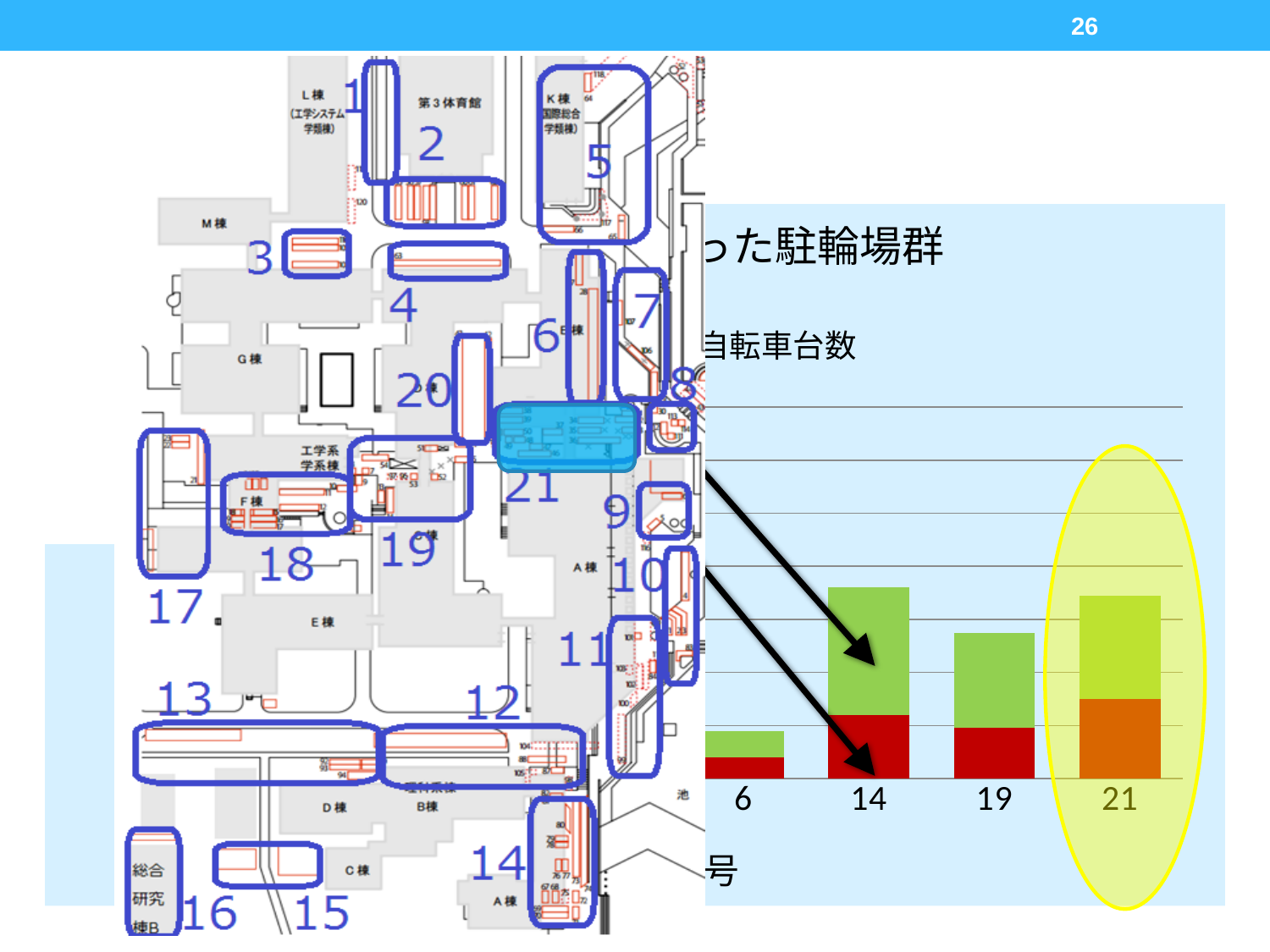
Which is larger, the total bar for category 21 or for category 19? 21 What two colours are used for the stacked segments of the bars? green and red How many category labels are visible on the x axis of the chart? 4 Which is larger, the total bar for category 14 or for category 19? 14 Among the visible categories, which has the largest green (top) segment? 14 Which category on the x axis is circled with a yellow ellipse? 21 Which is larger, the total bar for category 6 or for category 19? 19 What kind of chart is shown on the right side of the slide? bar chart Among the visible categories 6, 14, 19 and 21, which has the lowest total bar? 6 Among the visible categories, which has the largest red (bottom) segment? 21